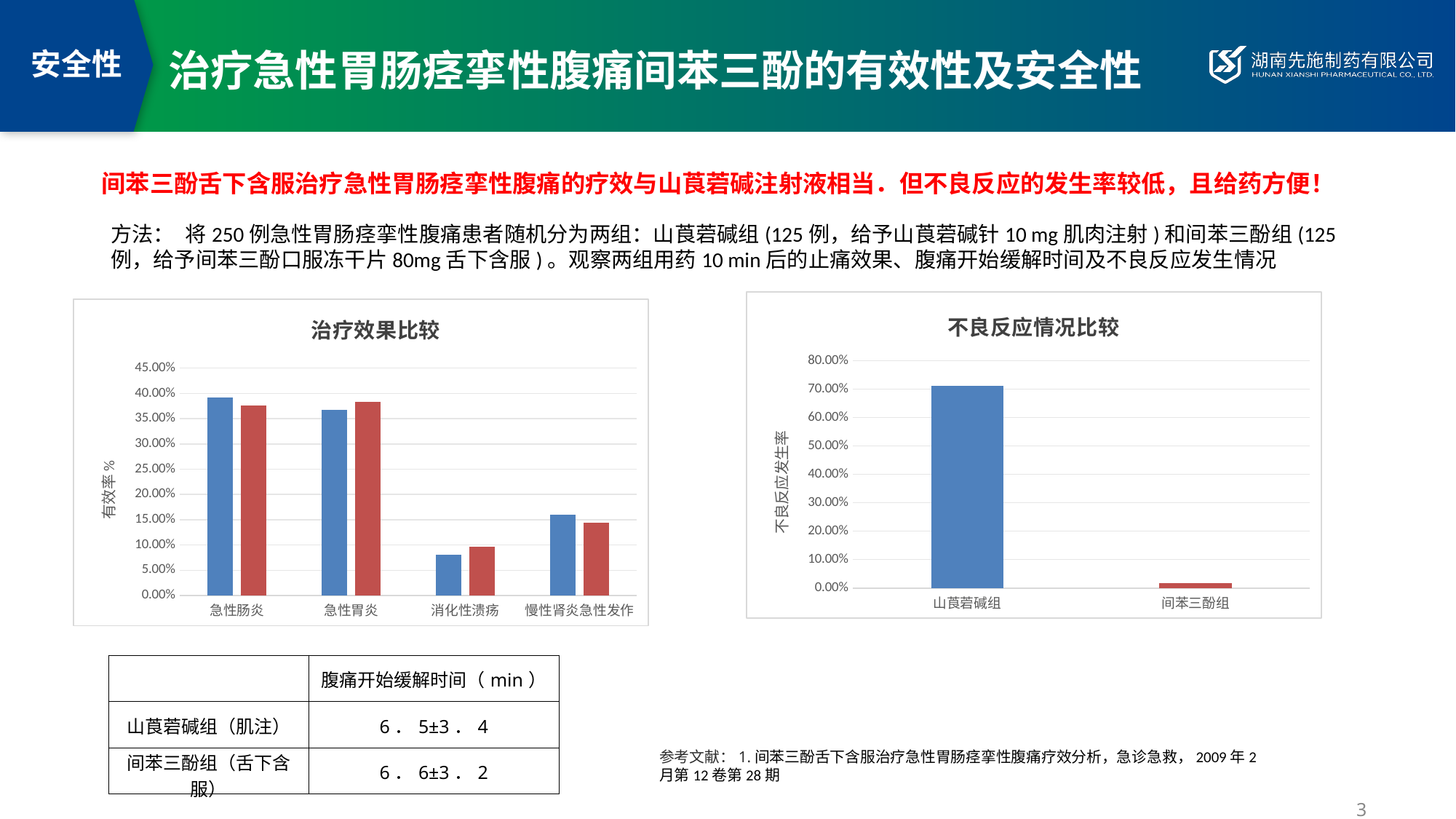
In the left chart 治疗效果比较, is the blue bar for 消化性溃疡 greater or less than 10.00%? less What is the y-axis title of the right chart 不良反应情况比较? 不良反应发生率 How many categories are shown on the x axis of the left chart 治疗效果比较? 4 In the left chart 治疗效果比较, which category has the lowest bars overall? 消化性溃疡 In the right chart 不良反应情况比较, which group has the highest adverse reaction rate? 山莨菪碱组 What kind of chart is the right chart titled 不良反应情况比较? bar chart What kind of chart is the left chart titled 治疗效果比较? bar chart In the right chart 不良反应情况比较, is the value for 间苯三酚组 greater or less than 10.00%? less In the right chart 不良反应情况比较, which group has the lowest adverse reaction rate? 间苯三酚组 How many categories are shown on the x axis of the right chart 不良反应情况比较? 2 In the right chart 不良反应情况比较, is the value for 山莨菪碱组 greater or less than 60.00%? greater